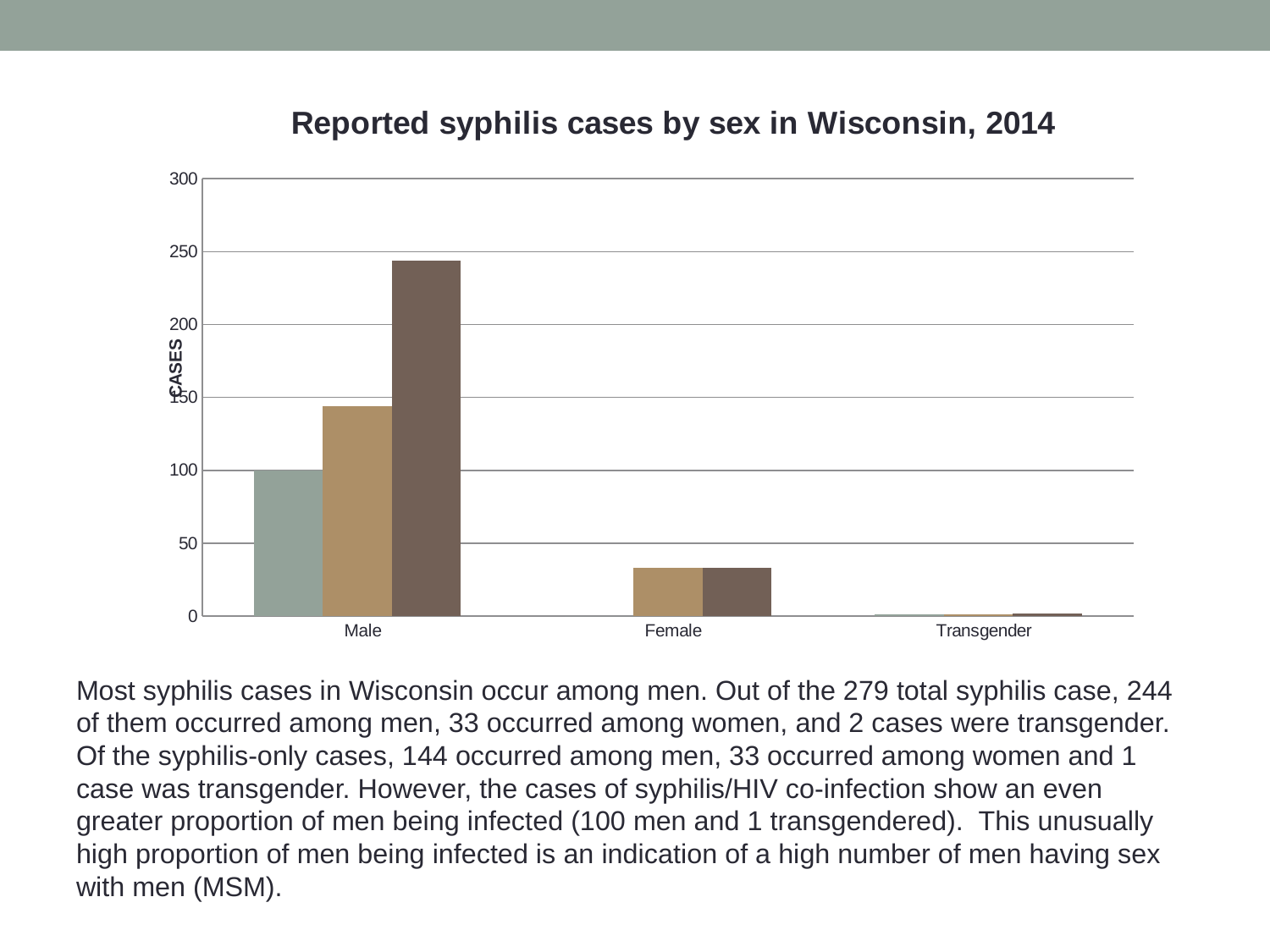
What value does the first (grey-green) bar for Male reach on the y axis? 100 Which category has the tallest bar in the chart? Male Are the bars for Transgender greater or less than 50? less Are the bars for Female greater or less than 50? less Is the tallest bar for Male greater or less than 200? greater Which category has higher bars, Male or Female? Male Which category has the shortest bars in the chart? Transgender What is the label on the y axis of the chart? CASES What is the title of the chart? Reported syphilis cases by sex in Wisconsin, 2014 How many categories are shown on the x axis of the chart? 3 What kind of chart is shown on the slide? bar chart